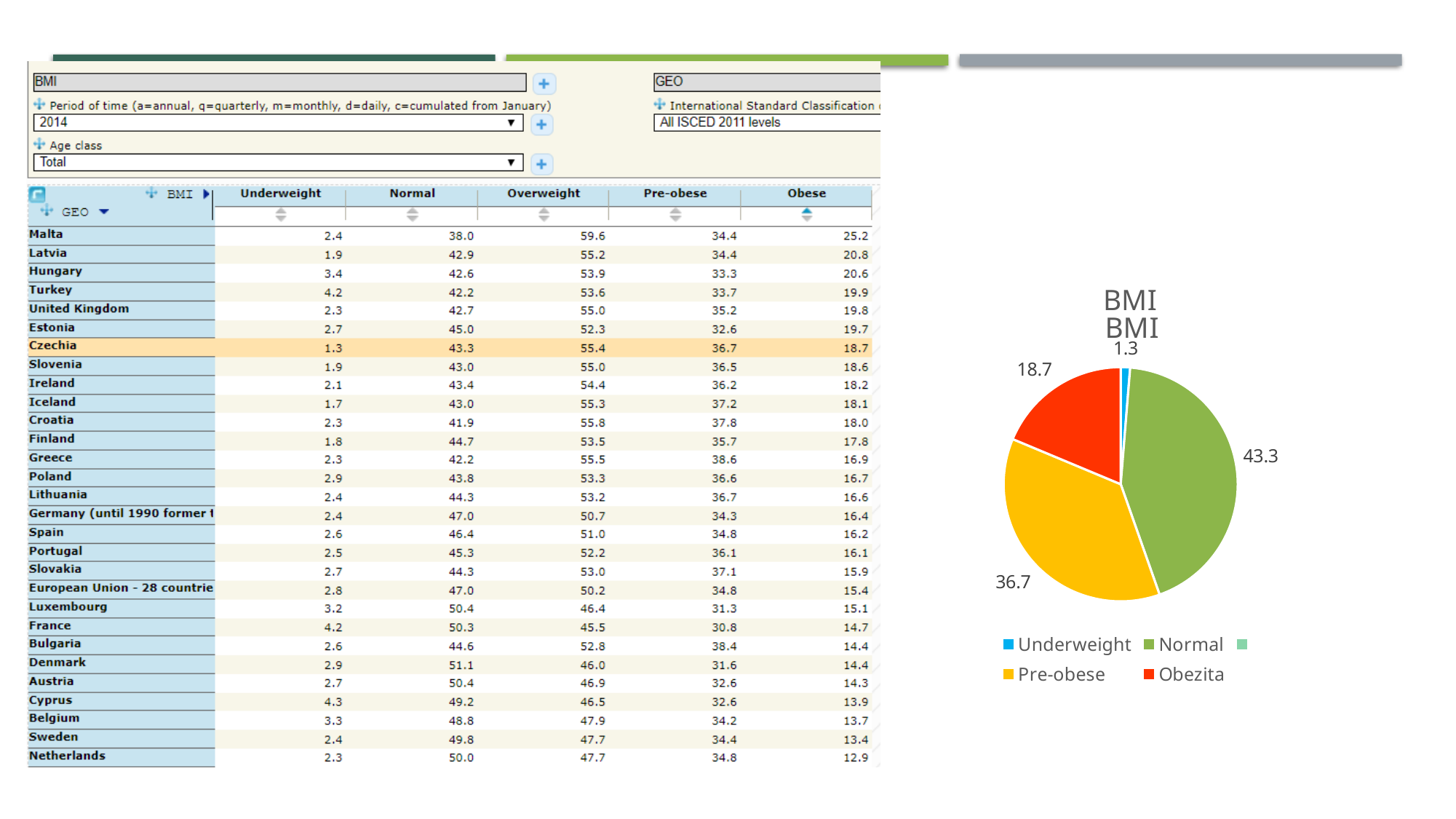
In the BMI pie chart, what is the value for Obezita? 18.7 Which category has the largest slice in the BMI pie chart? Normal In the BMI pie chart, what is the value for Normal? 43.3 In the BMI pie chart, which is larger, Pre-obese or Obezita? Pre-obese In the BMI pie chart, what is the difference between the Obezita and Underweight values? 17.4 What is the title of the pie chart? BMI What type of chart is shown on the right side of the slide? pie chart What colour is the Pre-obese slice in the BMI pie chart? yellow In the BMI pie chart, what is the value for Underweight? 1.3 In the BMI pie chart, what is the difference between the Normal and Pre-obese values? 6.6 Which category has the smallest slice in the BMI pie chart? Underweight In the BMI pie chart, what is the value for Pre-obese? 36.7